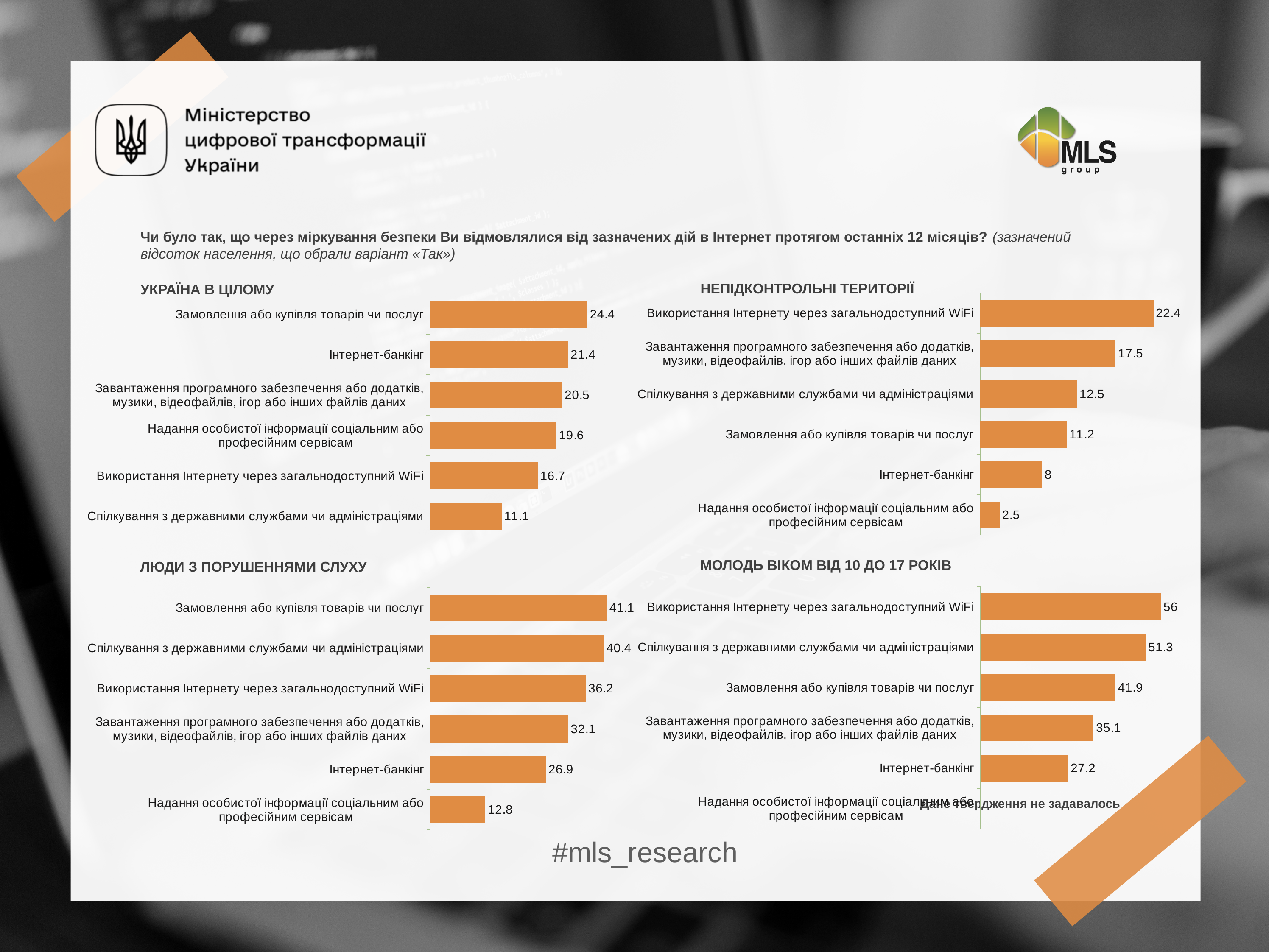
In the chart titled "МОЛОДЬ ВІКОМ ВІД 10 ДО 17 РОКІВ", what is the difference between the values for "Спілкування з державними службами чи адміністраціями" and "Інтернет-банкінг"? 24.1 In the chart titled "МОЛОДЬ ВІКОМ ВІД 10 ДО 17 РОКІВ", what is the value for "Використання Інтернету через загальнодоступний WiFi"? 56 In the chart titled "ЛЮДИ З ПОРУШЕННЯМИ СЛУХУ", which is larger: the value for "Інтернет-банкінг" or the value for "Надання особистої інформації соціальним або професійним сервісам"? Інтернет-банкінг In the chart titled "МОЛОДЬ ВІКОМ ВІД 10 ДО 17 РОКІВ", what text is shown instead of a bar for "Надання особистої інформації соціальним або професійним сервісам"? дане твердження не задавалось In the chart titled "НЕПІДКОНТРОЛЬНІ ТЕРИТОРІЇ", which category has the lowest value? Надання особистої інформації соціальним або професійним сервісам In the chart titled "УКРАЇНА В ЦІЛОМУ", which category has the highest value? Замовлення або купівля товарів чи послуг In the chart titled "НЕПІДКОНТРОЛЬНІ ТЕРИТОРІЇ", what is the difference between the values for "Використання Інтернету через загальнодоступний WiFi" and "Замовлення або купівля товарів чи послуг"? 11.2 How many categories are shown in the chart titled "УКРАЇНА В ЦІЛОМУ"? 6 In the chart titled "УКРАЇНА В ЦІЛОМУ", what is the value for "Інтернет-банкінг"? 21.4 In the chart titled "НЕПІДКОНТРОЛЬНІ ТЕРИТОРІЇ", what is the value for "Інтернет-банкінг"? 8 What type of chart is the chart titled "ЛЮДИ З ПОРУШЕННЯМИ СЛУХУ"? Bar chart In the chart titled "ЛЮДИ З ПОРУШЕННЯМИ СЛУХУ", what is the value for "Використання Інтернету через загальнодоступний WiFi"? 36.2